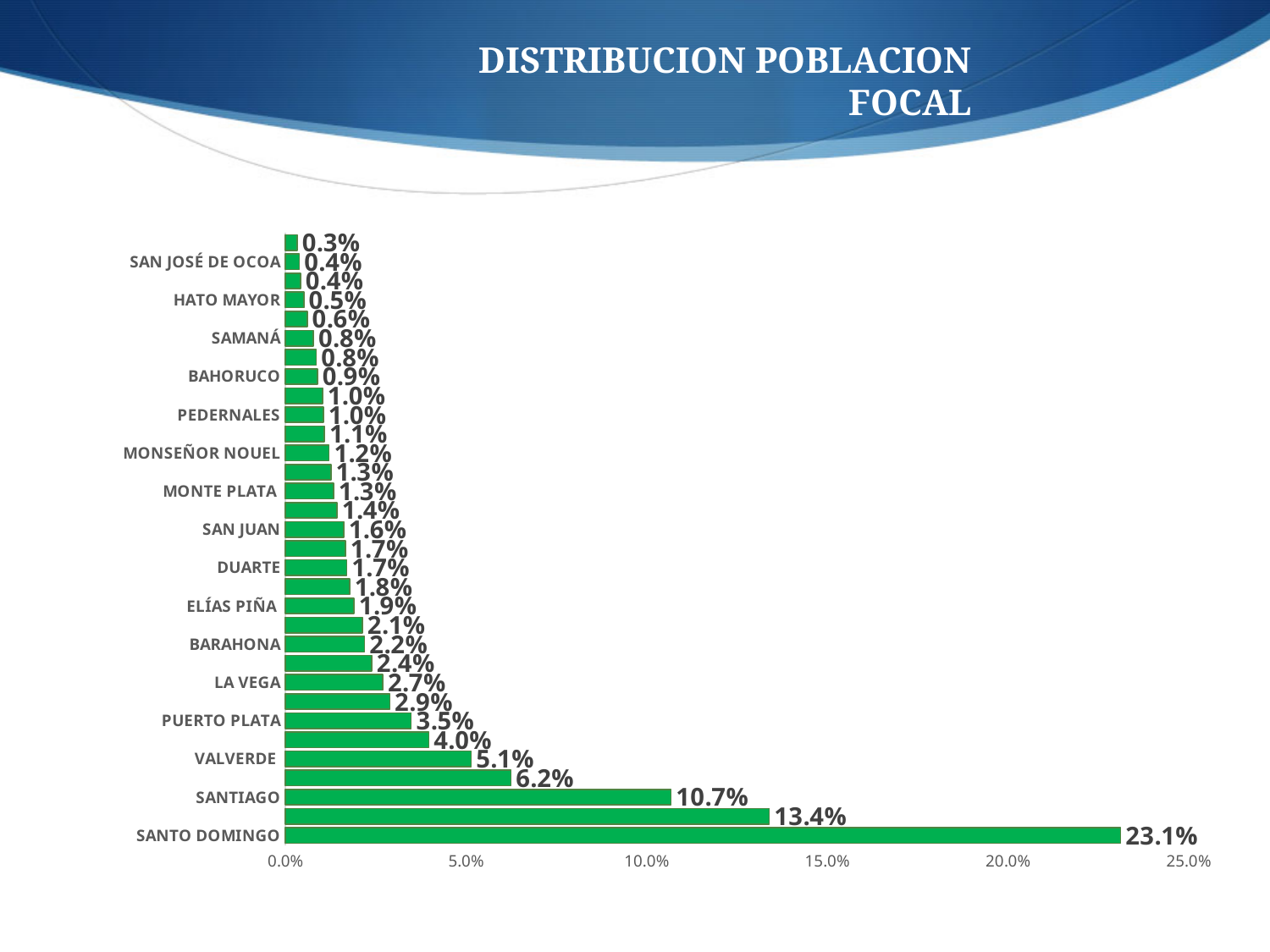
What is the value for VALVERDE? 5.1% What kind of chart is shown on the slide? bar chart Which labeled province has the highest value? SANTO DOMINGO What is the value for SANTIAGO? 10.7% What is the difference between the values for SANTO DOMINGO and SANTIAGO? 12.4% What is the title of the chart on the slide? DISTRIBUCION POBLACION FOCAL Is the value for SANTO DOMINGO greater or less than 20.0%? greater What is the value for LA VEGA? 2.7% What is the difference between the values for VALVERDE and PUERTO PLATA? 1.6% What is the value for PUERTO PLATA? 3.5% Which is larger, the value for BARAHONA or the value for SAN JUAN? BARAHONA What is the value for SANTO DOMINGO? 23.1%